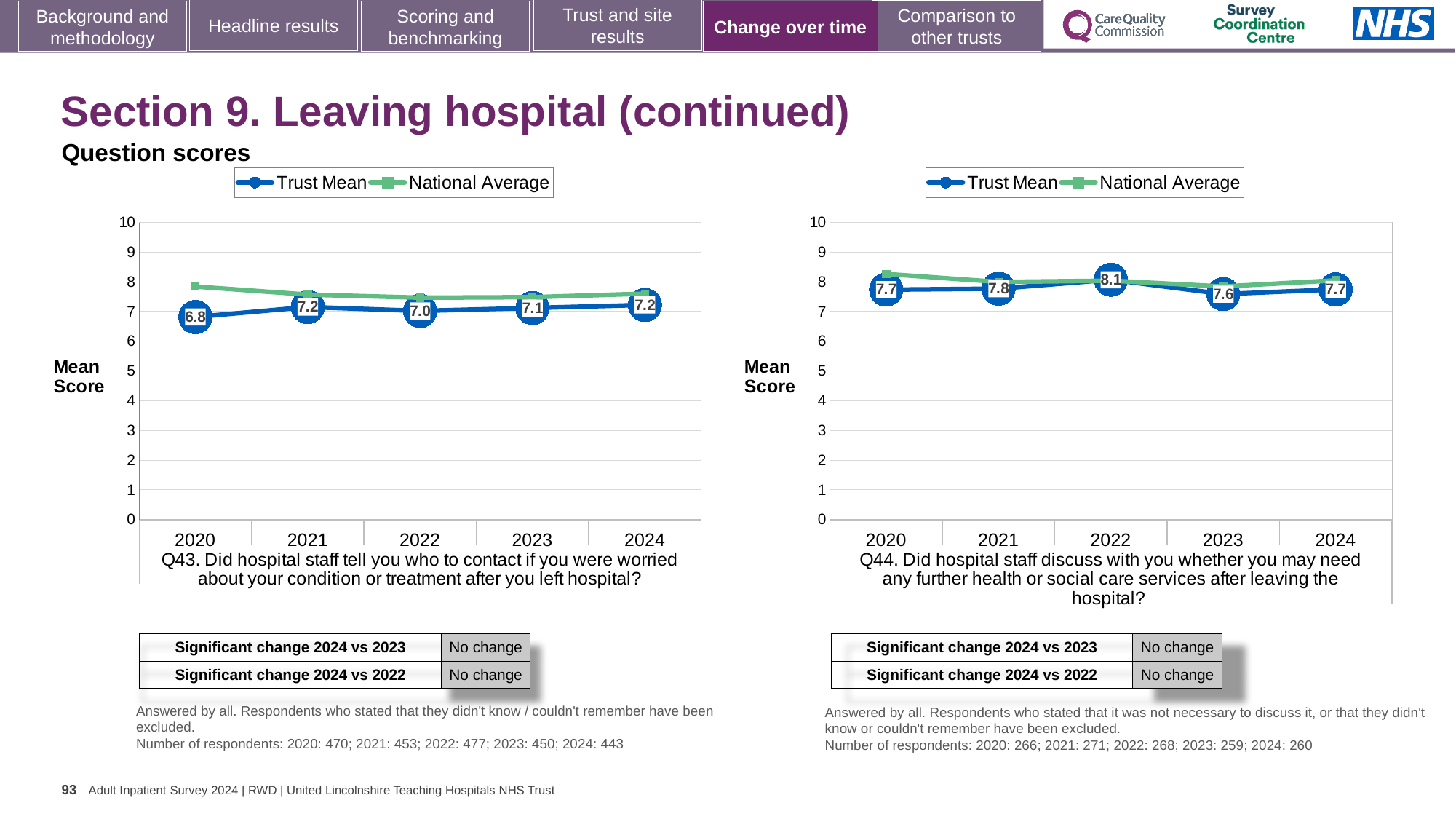
In the Q43 chart on the left, which year has the lowest Trust Mean score? 2020 In the Q44 chart on the right, which year has the highest Trust Mean score? 2022 In the Q43 chart on the left, which is larger: the Trust Mean for 2021 or the Trust Mean for 2022? 2021 How many years are plotted on the x axis of the Q44 chart on the right? 5 In the Q43 chart on the left, what is the Trust Mean score for 2024? 7.2 In the Q43 chart on the left, does the Trust Mean rise or fall from 2020 to 2021? Rise In the Q44 chart on the right, what is the difference between the Trust Mean scores for 2022 and 2023? 0.5 In the Q44 chart on the right, what is the Trust Mean score for 2022? 8.1 In the Q43 chart on the left, is the National Average for 2020 greater or less than 7? greater In the Q43 chart on the left, what is the Trust Mean score for 2020? 6.8 How many series does the legend of the Q43 chart on the left list? 2 What type of chart is used for Q44 on the right? Line chart